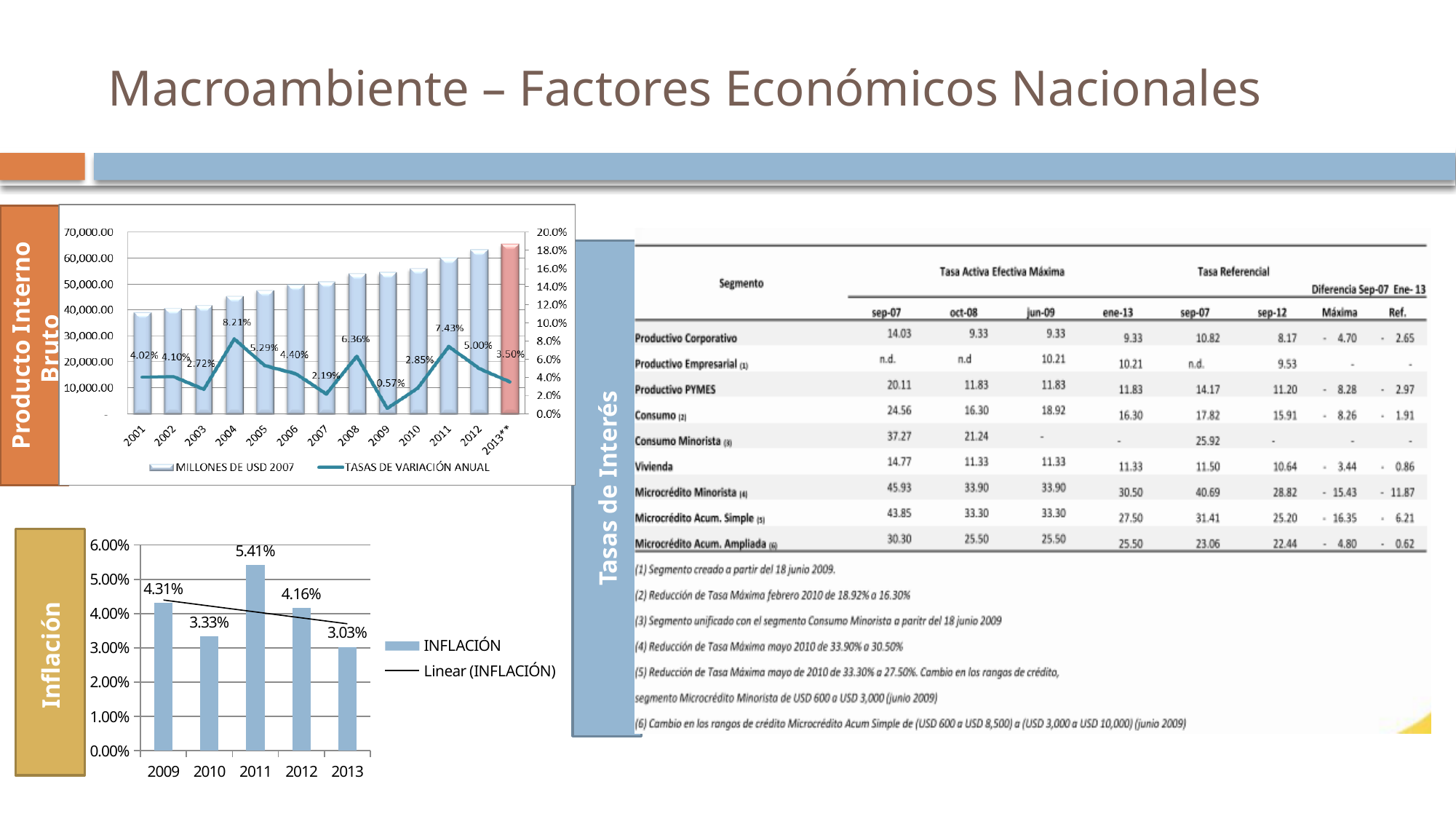
In the Inflación chart, how many years are shown on the x axis? 5 In the Inflación chart, what is the inflation value for 2013? 3.03% In the Inflación chart, which year has the lowest inflation? 2013 In the Inflación chart, which year has the highest inflation? 2011 In the Producto Interno Bruto chart, is the annual variation rate higher in 2008 or in 2011? 2011 In the Producto Interno Bruto chart, is the MILLONES DE USD 2007 value for 2012 greater or less than 60,000.00? greater In the Producto Interno Bruto chart, what is the annual variation rate (TASAS DE VARIACIÓN ANUAL) for 2004? 8.21% In the Inflación chart, what is the inflation value for 2011? 5.41% In the Producto Interno Bruto chart, do the MILLONES DE USD 2007 bars rise or fall from 2001 to 2013**? rise In the Inflación chart, how many entries does the legend list? 2 In the Inflación chart, what is the difference between the inflation values for 2009 and 2010? 0.98% In the Producto Interno Bruto chart, which year has the lowest annual variation rate? 2009